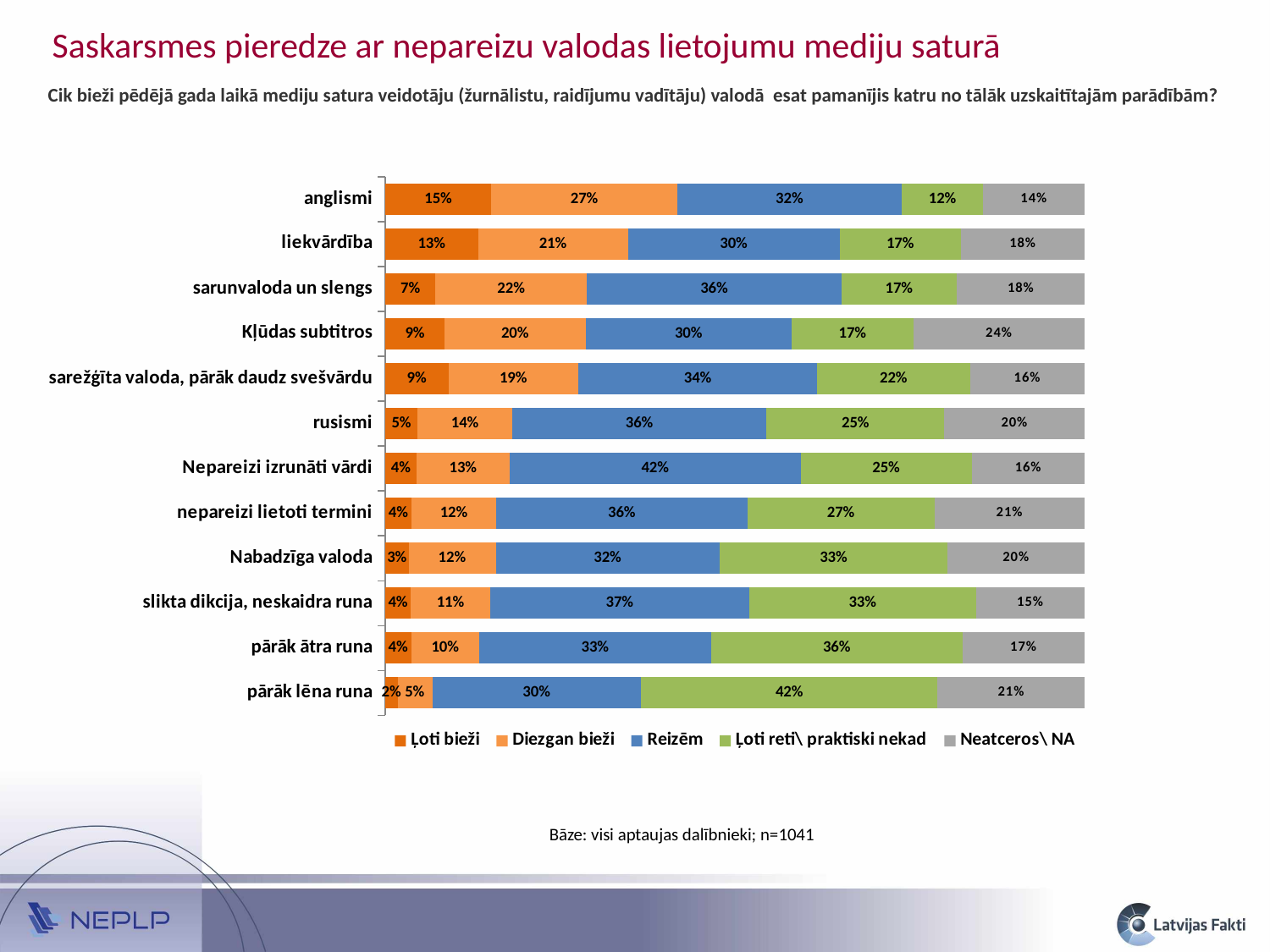
Which category has the highest "Ļoti bieži" value? anglismi What kind of chart is shown on the slide? Stacked bar chart Which is larger: the "Reizēm" value for rusismi or for Nabadzīga valoda? rusismi What is the difference between the "Diezgan bieži" values for anglismi and liekvārdība? 6% What is the "Reizēm" value for Nepareizi izrunāti vārdi? 42% How many series does the legend list? 5 Which category has the highest "Ļoti reti\ praktiski nekad" value? pārāk lēna runa What percentage of respondents answered "Ļoti bieži" for anglismi? 15% What is the "Neatceros\ NA" value for Kļūdas subtitros? 24% What is the total of the stacked bar for anglismi? 100% How many categories are shown in the chart? 12 Which category has the lowest "Ļoti bieži" value? pārāk lēna runa